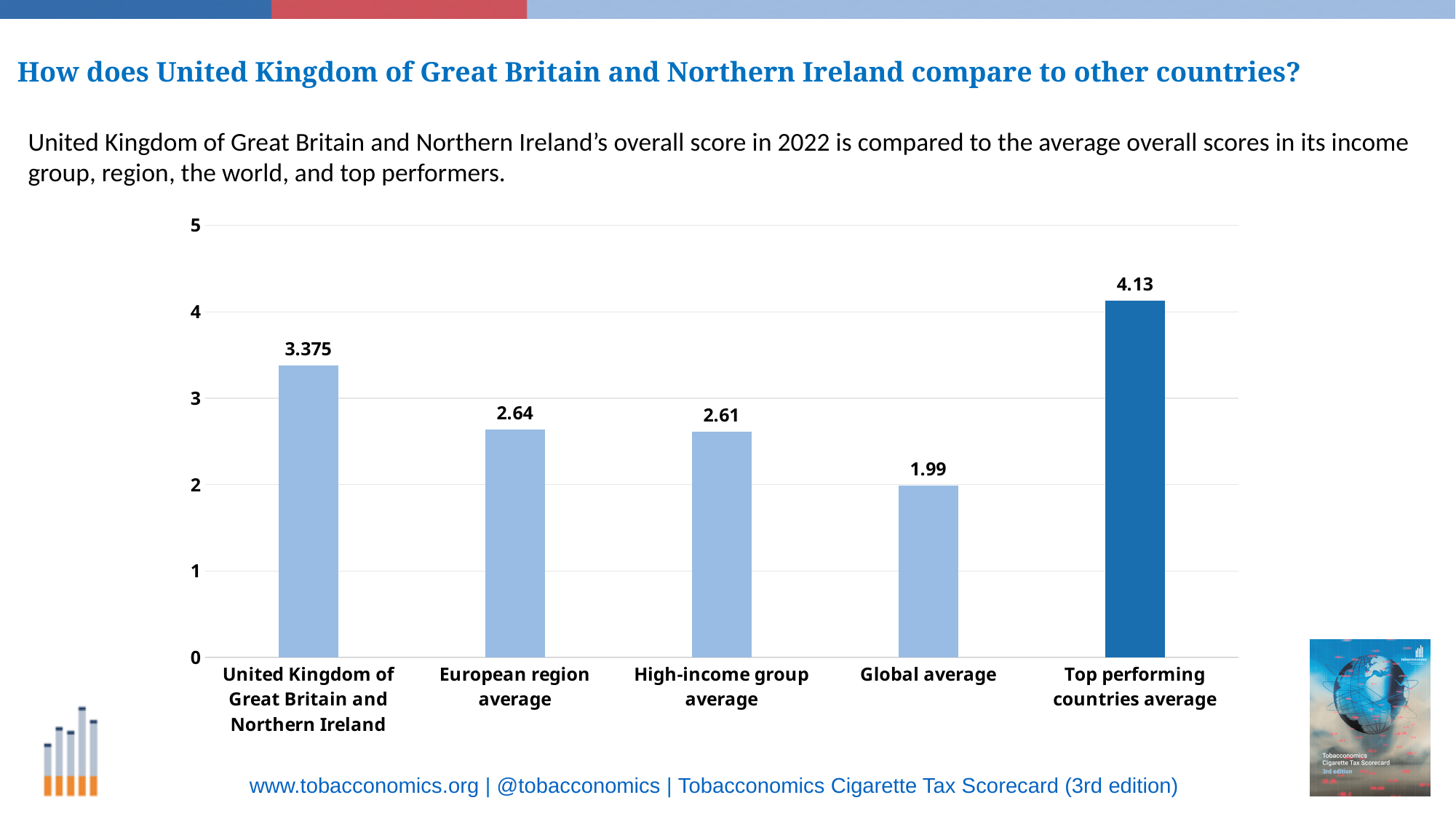
What is the difference between the United Kingdom of Great Britain and Northern Ireland score and the Global average? 1.385 What is the value for the Global average? 1.99 What is the value for the Top performing countries average? 4.13 What is the difference between the Top performing countries average and the United Kingdom of Great Britain and Northern Ireland score? 0.755 How many categories are shown in the chart? 5 Which category has the lowest value? Global average What kind of chart is shown on the slide? Bar chart What is the value for the European region average? 2.64 What is the overall score for United Kingdom of Great Britain and Northern Ireland? 3.375 What is the value for the High-income group average? 2.61 Which is larger, the United Kingdom of Great Britain and Northern Ireland score or the European region average? United Kingdom of Great Britain and Northern Ireland Which category has the highest value? Top performing countries average